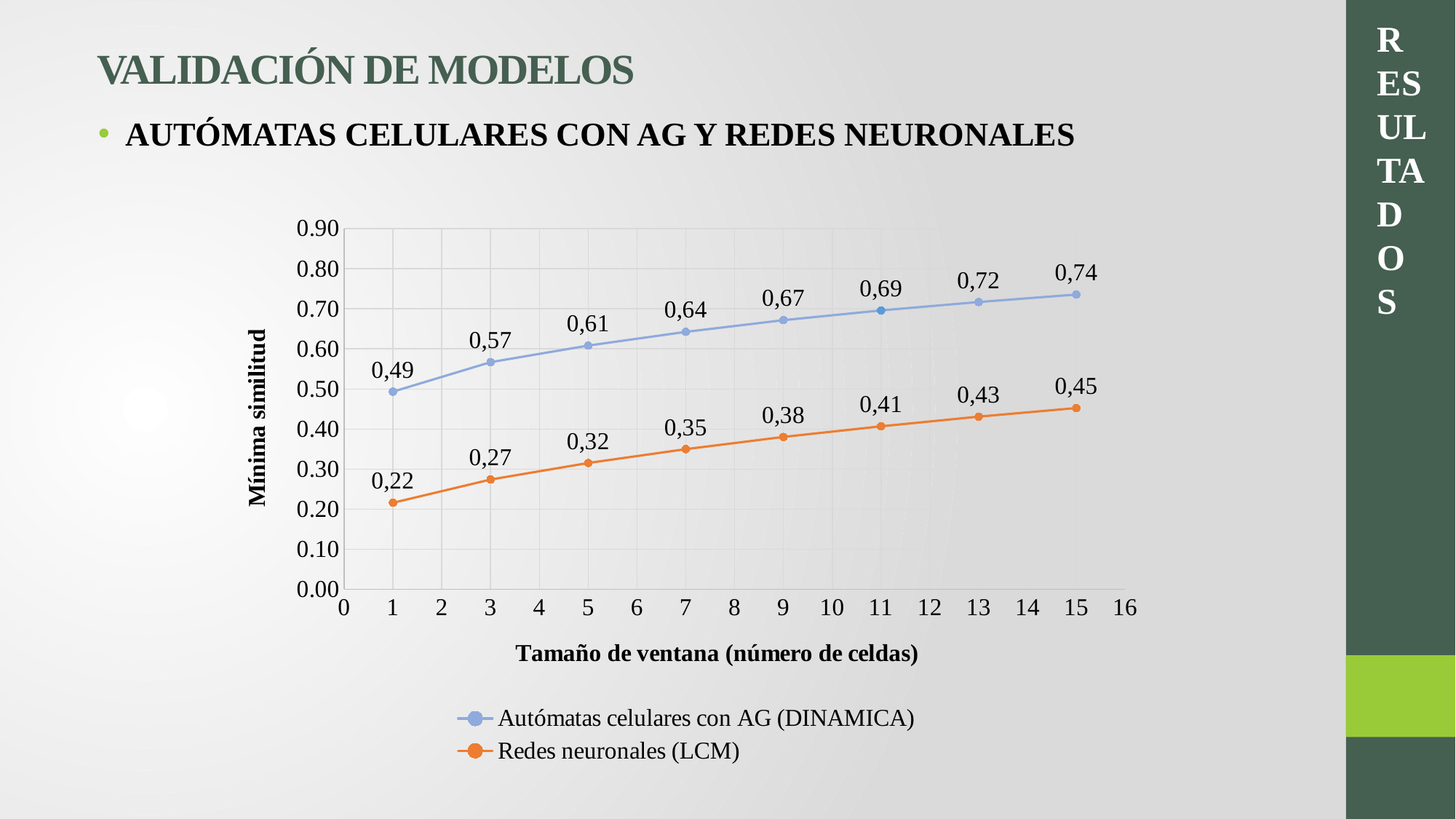
At which window size does Redes neuronales (LCM) have its lowest value? 1 What is the difference between the two series at window size 15? 0,29 Which series has the larger value at window size 5? Autómatas celulares con AG (DINAMICA) What kind of chart is shown? Line chart How many series does the legend list? 2 What is the value for Autómatas celulares con AG (DINAMICA) at window size 9? 0,67 How many data points are plotted for each series? 8 What is the value for Redes neuronales (LCM) at window size 15? 0,45 At which window size does Autómatas celulares con AG (DINAMICA) reach its highest value? 15 What is the value for Redes neuronales (LCM) at window size 7? 0,35 Do the values for Redes neuronales (LCM) rise or fall as the window size increases? Rise What is the value for Autómatas celulares con AG (DINAMICA) at window size 1? 0,49